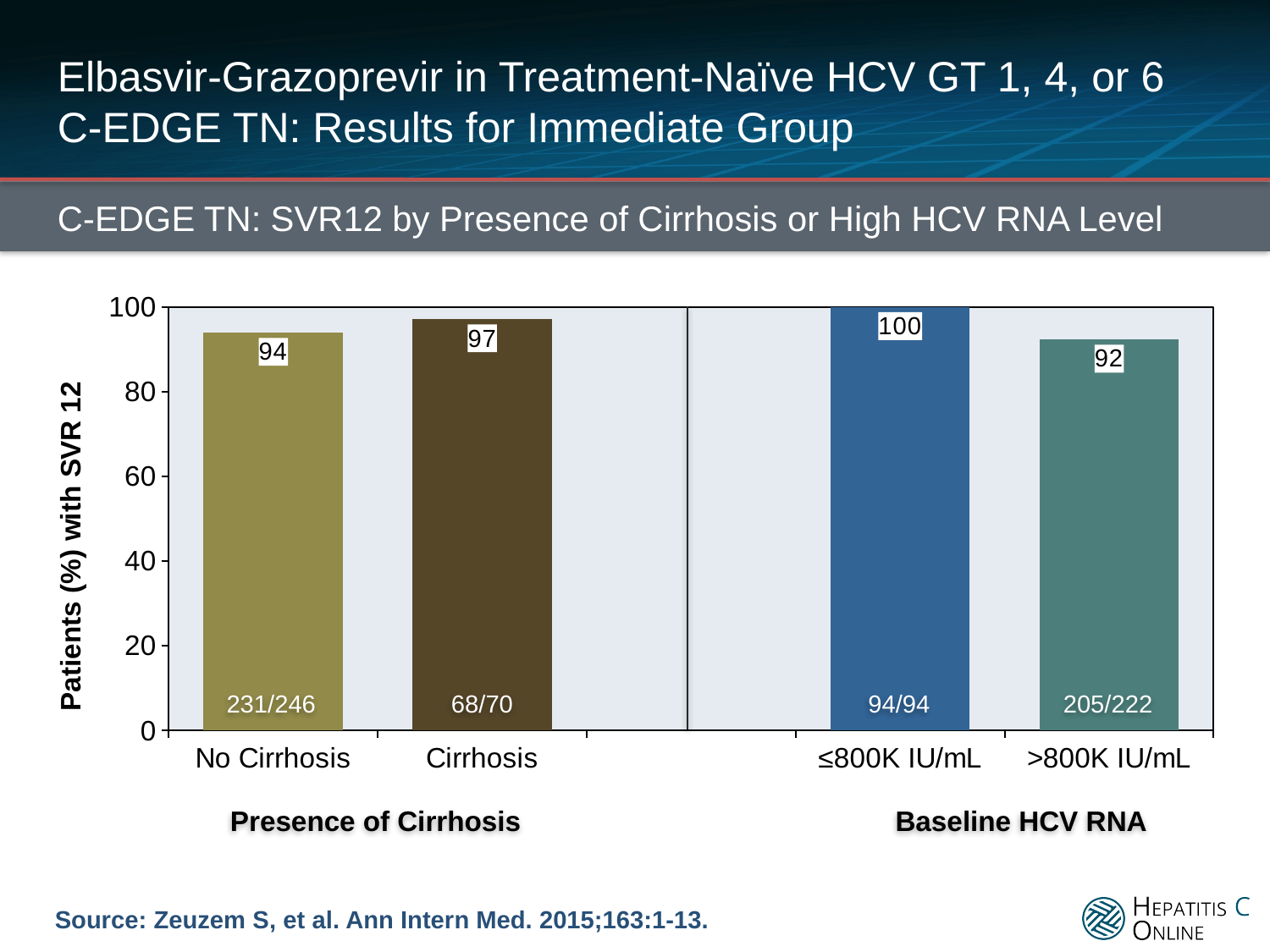
Which category has the lowest SVR12 rate? >800K IU/mL What fraction of patients is shown inside the >800K IU/mL bar? 205/222 How many bars are plotted in the chart? 4 Which has a higher SVR12 rate, ≤800K IU/mL or >800K IU/mL? ≤800K IU/mL What is the SVR12 rate (%) for the No Cirrhosis group? 94 What is the SVR12 rate (%) for the Cirrhosis group? 97 What is the SVR12 rate (%) for patients with baseline HCV RNA ≤800K IU/mL? 100 What fraction of patients is shown inside the No Cirrhosis bar? 231/246 What is the SVR12 rate (%) for patients with baseline HCV RNA >800K IU/mL? 92 What is the difference in SVR12 rate between the Cirrhosis and No Cirrhosis groups? 3 Which category has the highest SVR12 rate? ≤800K IU/mL What type of chart is shown on the slide? Bar chart